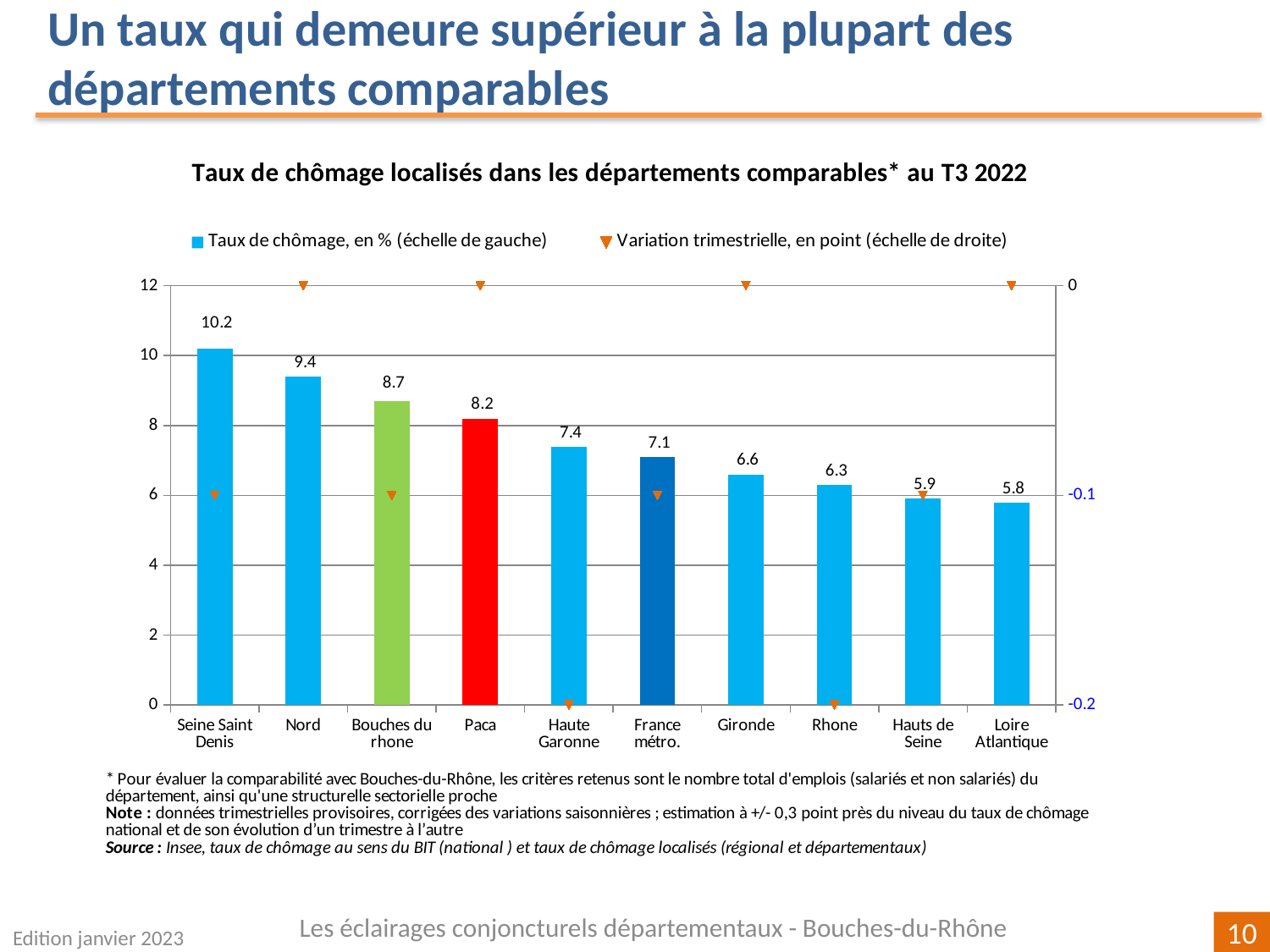
How many departments or areas are shown on the x axis? 10 Which has a higher unemployment rate, Nord or Gironde? Nord Do the unemployment rate bars rise or fall from left to right along the x axis? Fall What is the unemployment rate shown for Bouches du rhone? 8.7 Which department has the highest unemployment rate on the chart? Seine Saint Denis What is the difference between the unemployment rates of Bouches du rhone and Paca? 0.5 What is the quarterly variation (variation trimestrielle) shown for Rhone on the right-hand scale? -0.2 What is the unemployment rate (taux de chômage) for Seine Saint Denis? 10.2 What is the unemployment rate shown for France métro.? 7.1 How many series does the legend list? 2 Which department has the lowest unemployment rate on the chart? Loire Atlantique What kind of chart is used to show the unemployment rates? Bar chart